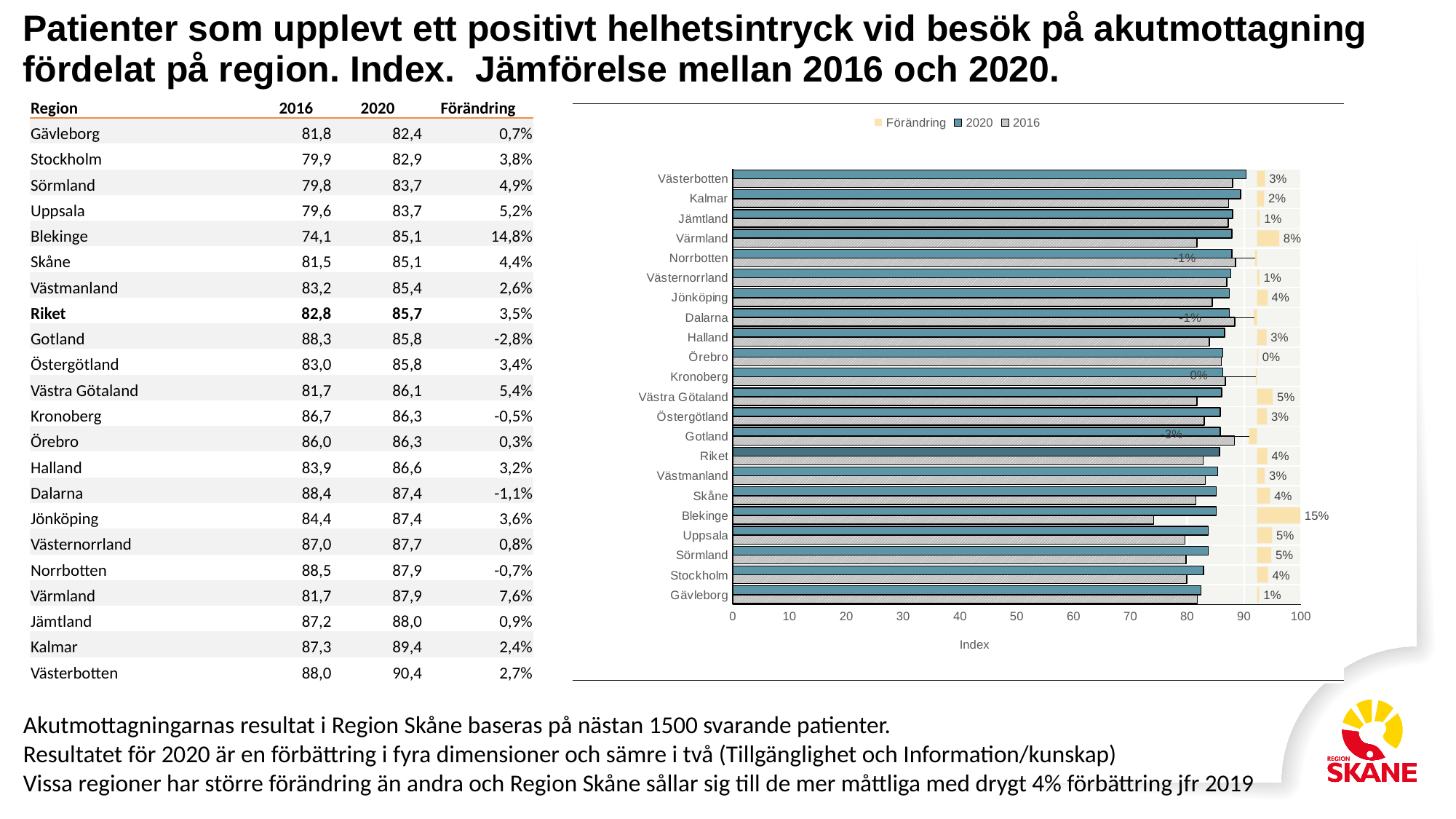
On the chart, which has the larger 2020 value, Västerbotten or Gävleborg? Västerbotten On the chart, is the 2016 value for Blekinge greater or less than 80? less What Förändring value is labelled for Gotland on the chart? -3% What Förändring value is labelled for Värmland on the chart? 8% How many series does the chart's legend list? 3 What is the title of the chart's horizontal axis? Index On the chart, is the 2020 value for Gävleborg greater or less than 90? less What kind of chart is shown on the right of the slide? bar chart What Förändring value is labelled for Skåne on the chart? 4% How many regions (categories) are plotted on the chart's vertical axis? 22 What Förändring value is labelled for Blekinge on the chart? 15% Which region has the highest Förändring value on the chart? Blekinge